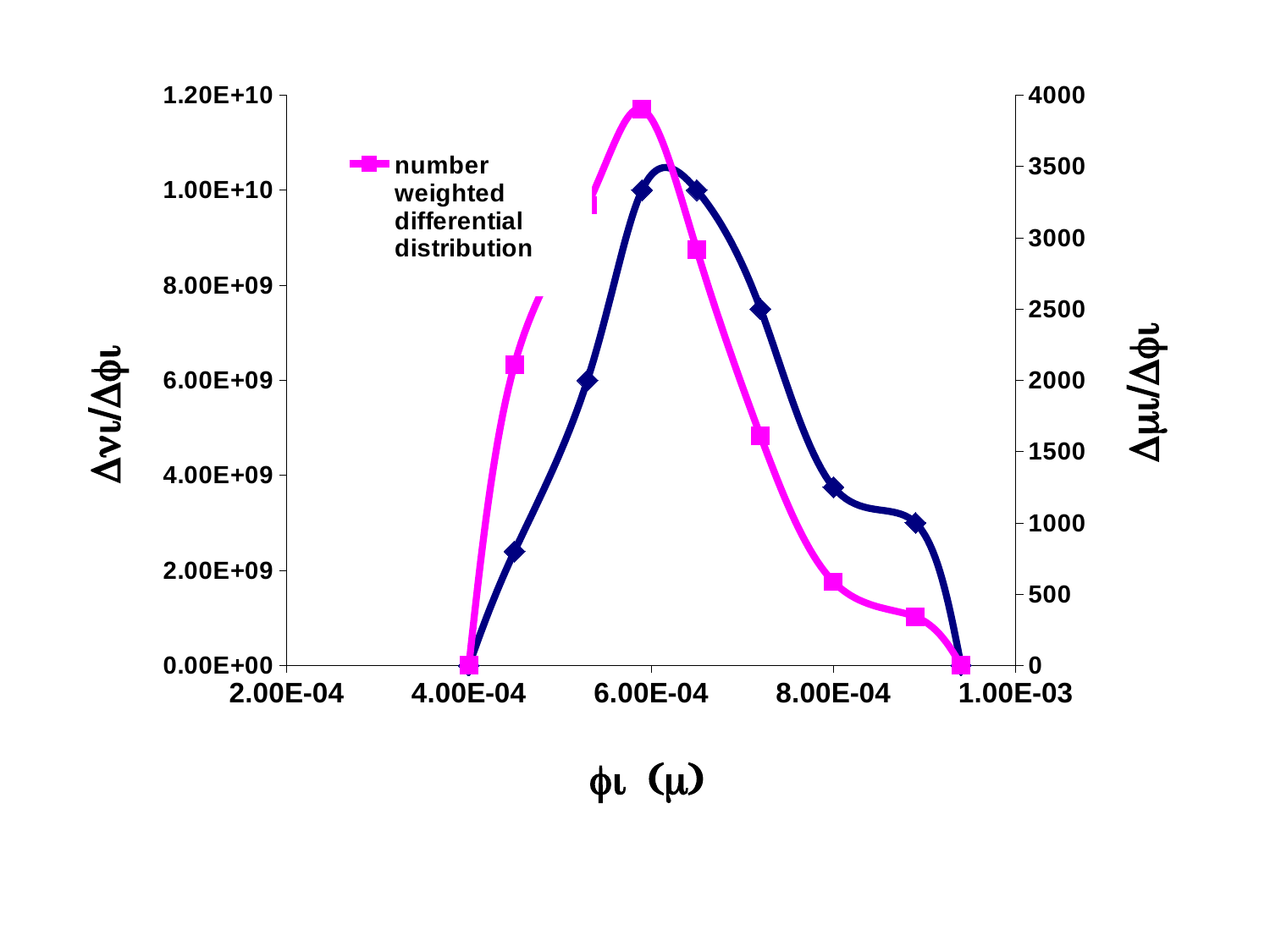
Does the number weighted differential distribution (magenta) series rise or fall between 6.00E-04 and 1.00E-03 on the x axis? fall Is the value of the number weighted differential distribution (magenta) series at 4.00E-04 greater or less than 2.00E+09 on the left axis? less What is the label on the x axis? φι (μ) What kind of chart is shown on the slide? line chart What is the highest tick value shown on the right-hand vertical axis? 4000 At 8.00E-04 on the x axis, which line is plotted higher on the chart, the magenta line or the dark blue line? the dark blue line Near which x-axis tick does the number weighted differential distribution (magenta) series reach its highest point? 6.00E-04 Does the dark blue series rise or fall between 4.00E-04 and 6.00E-04 on the x axis? rise Is the peak value of the number weighted differential distribution (magenta) series greater or less than 1.00E+10 on the left axis? greater How many series does the legend list? 1 What is the name of the series listed in the legend? number weighted differential distribution Is the value of the number weighted differential distribution (magenta) series at 8.00E-04 greater or less than 2.00E+09 on the left axis? less